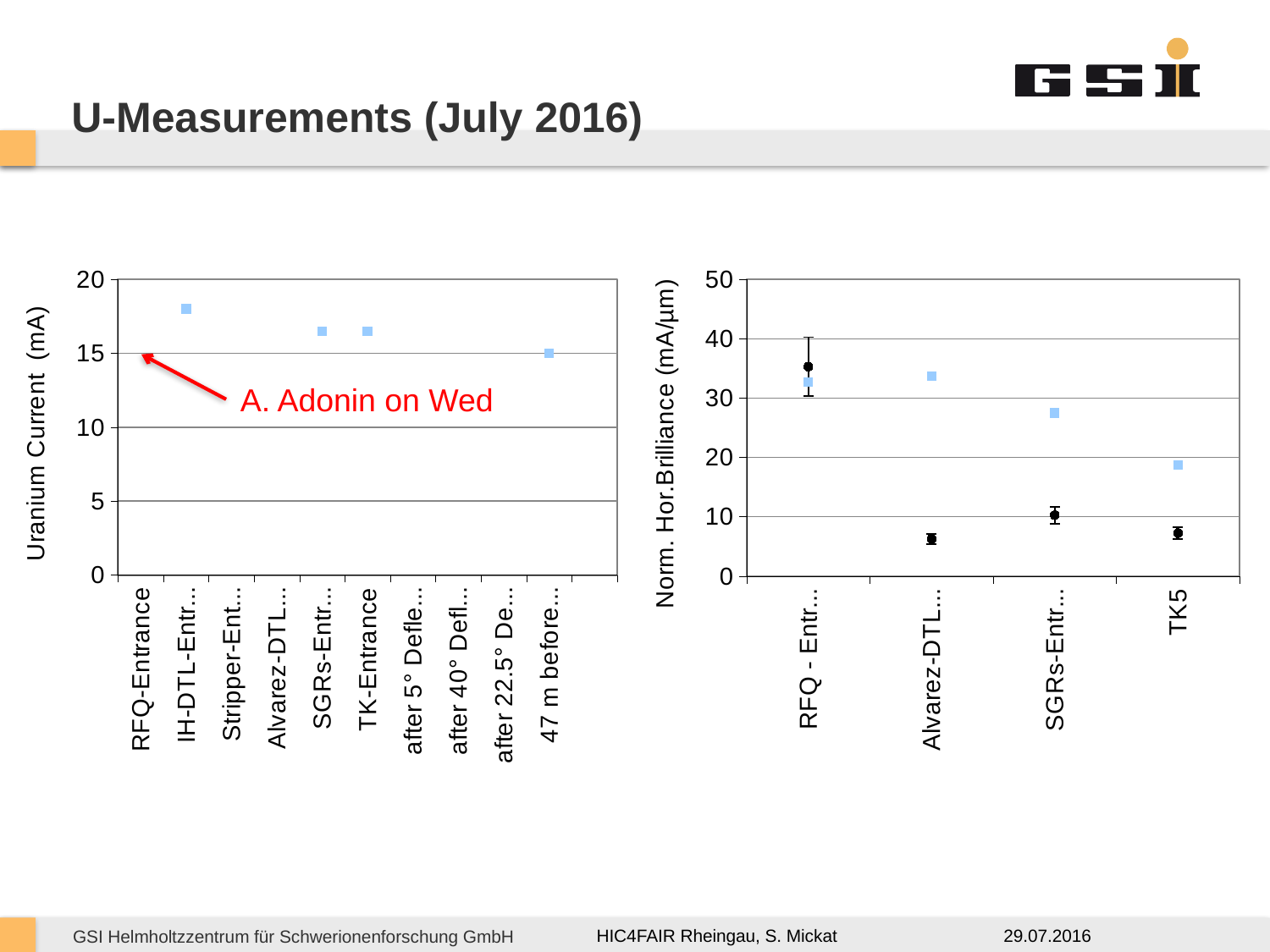
What is the y-axis label of the left chart? Uranium Current (mA) In the right chart (Norm. Hor.Brilliance), do the blue square values rise or fall from RFQ - Entr... to TK5? fall In the left chart (Uranium Current), is the value for SGRs-Entr... greater or less than 15? greater How many categories are listed on the x axis of the right chart (Norm. Hor.Brilliance)? 4 In the right chart (Norm. Hor.Brilliance), is the blue square value for TK5 greater or less than 20? less In the left chart (Uranium Current), is the value for IH-DTL-Entr... greater or less than 15? greater What kind of chart is the left chart (Uranium Current)? scatter chart How many categories are listed on the x axis of the left chart (Uranium Current)? 10 In the right chart (Norm. Hor.Brilliance), at SGRs-Entr..., which is larger: the blue square value or the black circle value? the blue square value In the right chart (Norm. Hor.Brilliance), which category has the lowest blue square value? TK5 In the left chart (Uranium Current), which category has the highest plotted value? IH-DTL-Entr...